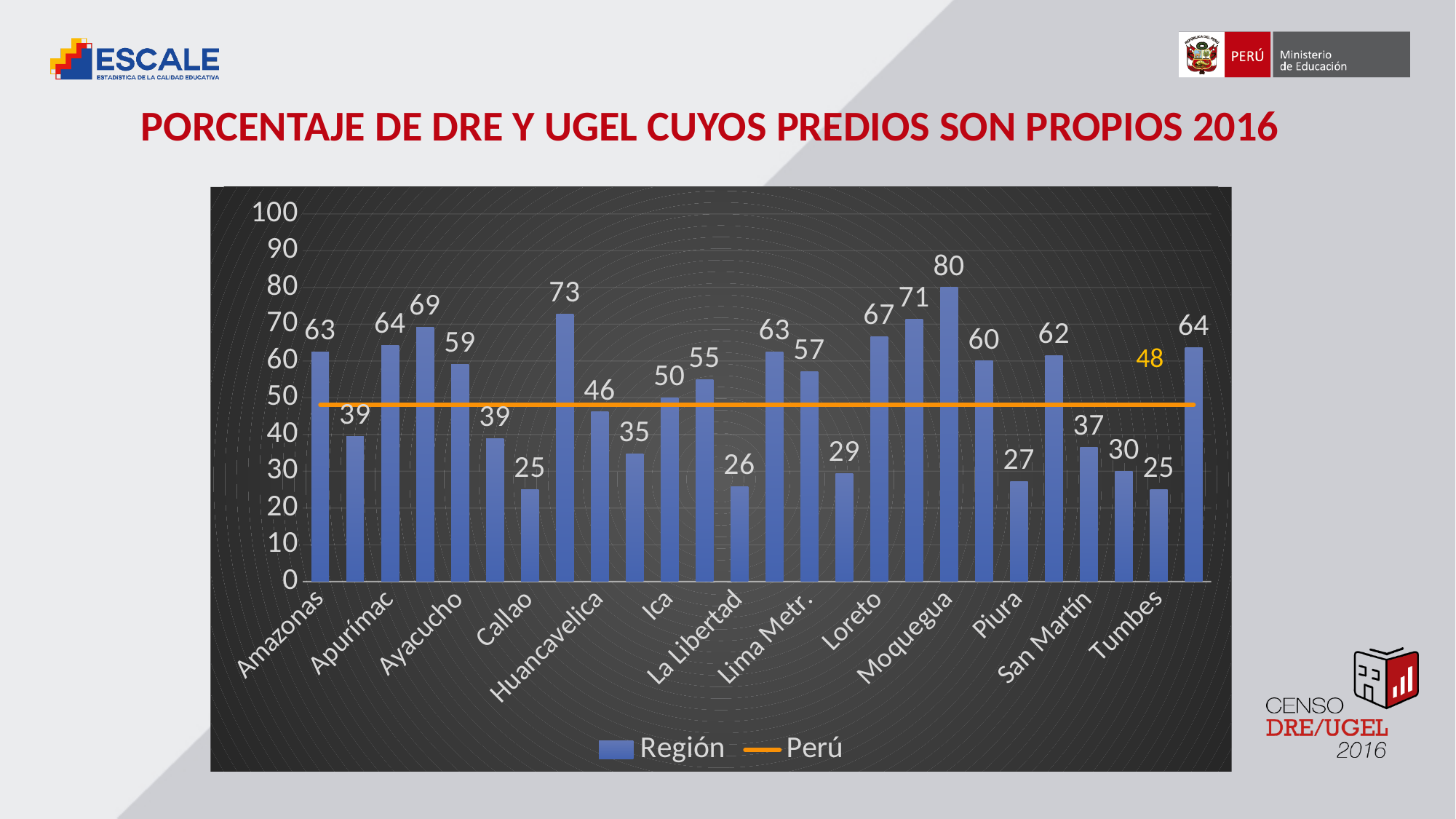
Which labeled region has the highest value? Moquegua What is the value for Huancavelica? 46 What is the value for Moquegua? 80 Is the value for Apurímac greater or less than the Perú line value of 48? greater Which is larger, the value for Loreto or the value for Ica? Loreto How many series does the legend list? 2 What is the value of the Perú line? 48 What is the difference between the values for Moquegua and Piura? 53 What is the value for Amazonas? 63 What is the title of the slide? PORCENTAJE DE DRE Y UGEL CUYOS PREDIOS SON PROPIOS 2016 What colour is the Perú line? orange What type of chart is shown on the slide? combination bar and line chart